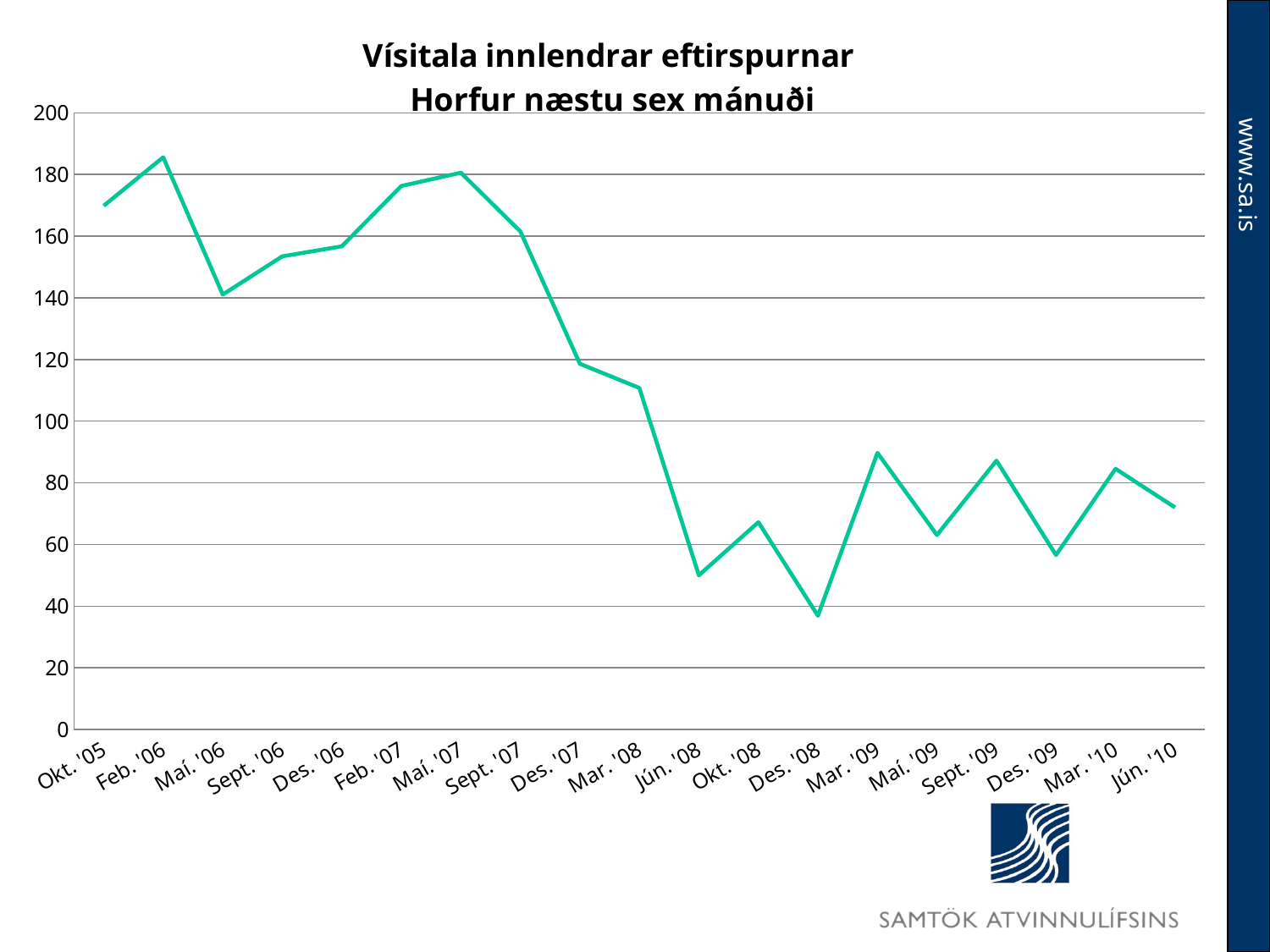
Overall, do the values rise or fall from Okt. '05 to Jún. '10? fall Is the value for Okt. '05 greater or less than 160? greater Is the value for Mar. '08 greater or less than 100? greater Which is larger, the value for Okt. '05 or the value for Jún. '10? Okt. '05 Which is larger, the value for Mar. '09 or the value for Des. '09? Mar. '09 What is the title of the chart? Vísitala innlendrar eftirspurnar Horfur næstu sex mánuði Is the value for Jún. '10 greater or less than 80? less How many data points are plotted along the x axis? 19 Which period has the lowest value on the chart? Des. '08 What kind of chart is shown on the slide? line chart